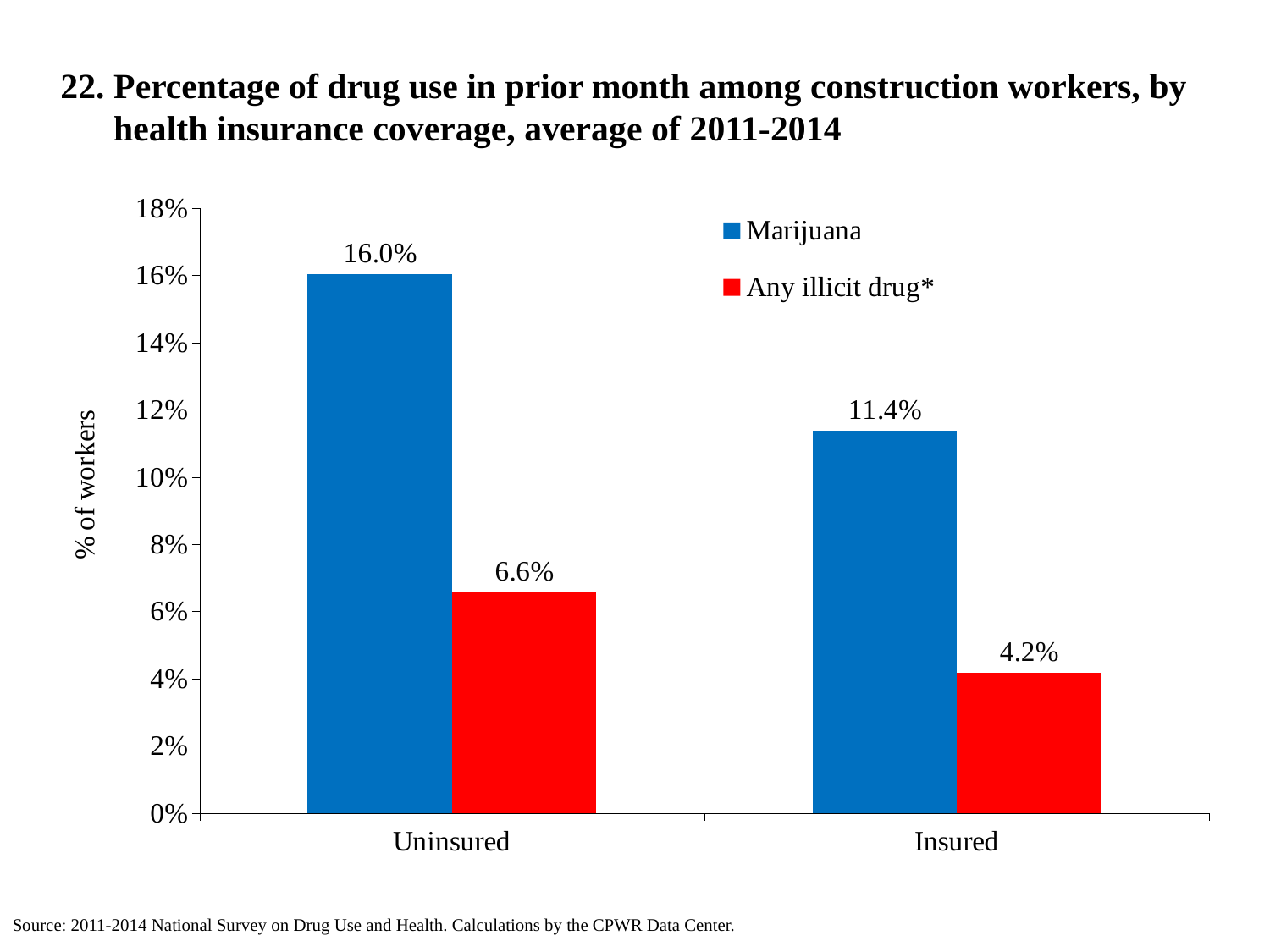
What is the difference between the Marijuana values for Uninsured and Insured workers? 4.6% What is the Marijuana value for Uninsured workers? 16.0% What is the difference between the Any illicit drug* values for Uninsured and Insured workers? 2.4% What kind of chart is shown on the slide? Bar chart Which insurance category has the lowest Any illicit drug* value? Insured What is the Marijuana value for Insured workers? 11.4% How many categories are shown on the x axis? 2 How many series does the legend list? 2 What is the Any illicit drug* value for Uninsured workers? 6.6% What is the Any illicit drug* value for Insured workers? 4.2% Which insurance category has the highest Marijuana value? Uninsured Which is larger: the Marijuana value for Insured workers or the Any illicit drug* value for Uninsured workers? Marijuana value for Insured workers